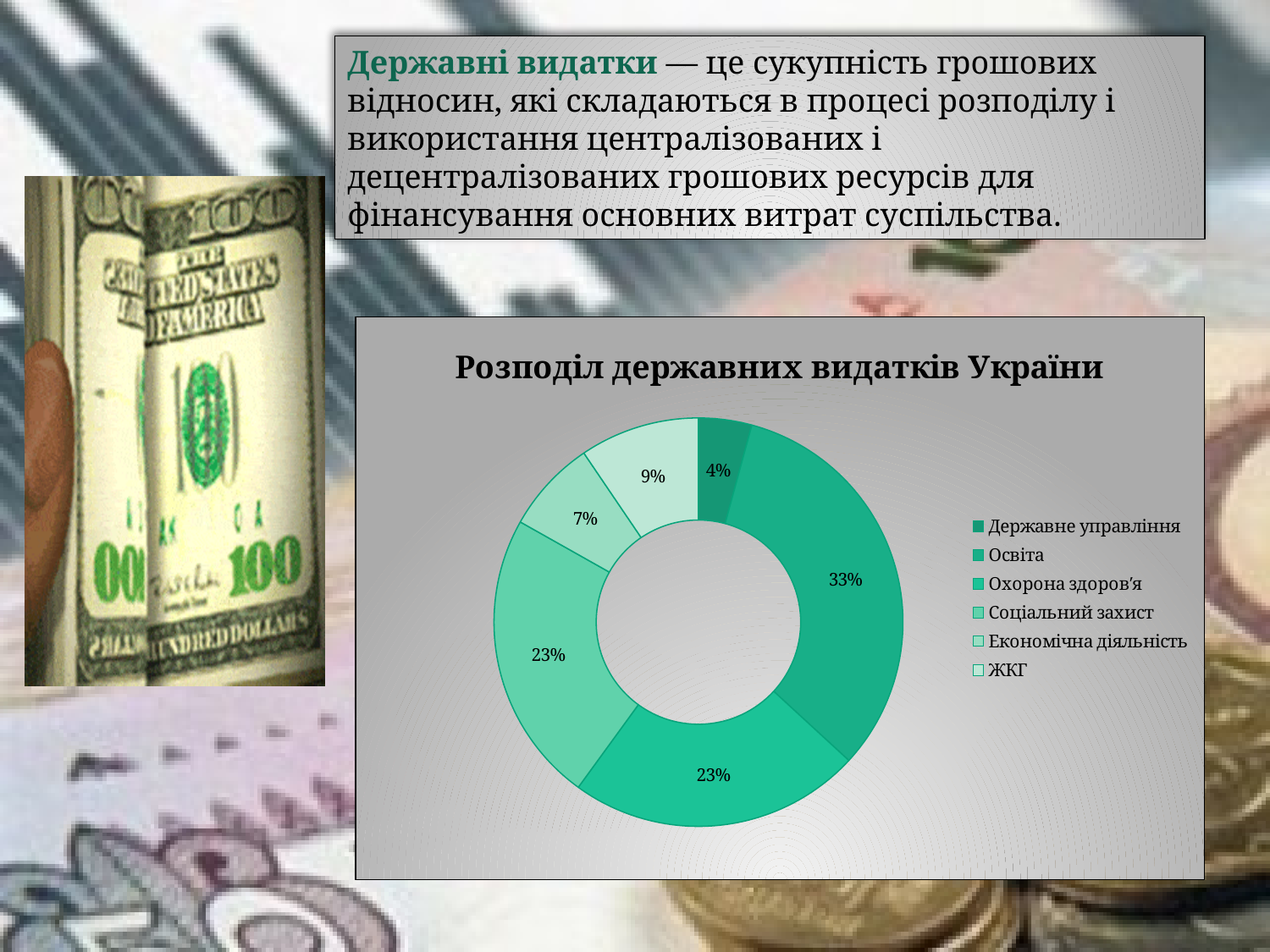
How many entries does the legend list? 6 Which is larger, the share for ЖКГ or the share for Економічна діяльність? ЖКГ What is the value shown for Державне управління? 4% What share of the chart does Освіта account for? 33% Which category has the smallest share of the chart? Державне управління What is the value for Економічна діяльність? 7% What is the difference between the shares of Освіта and Охорона здоров'я? 10% Which category has the largest share of the chart? Освіта What type of chart is shown on the slide? Doughnut chart What percentage is shown for ЖКГ? 9% What is the title of the chart? Розподіл державних видатків України How many categories are shown in the chart? 6